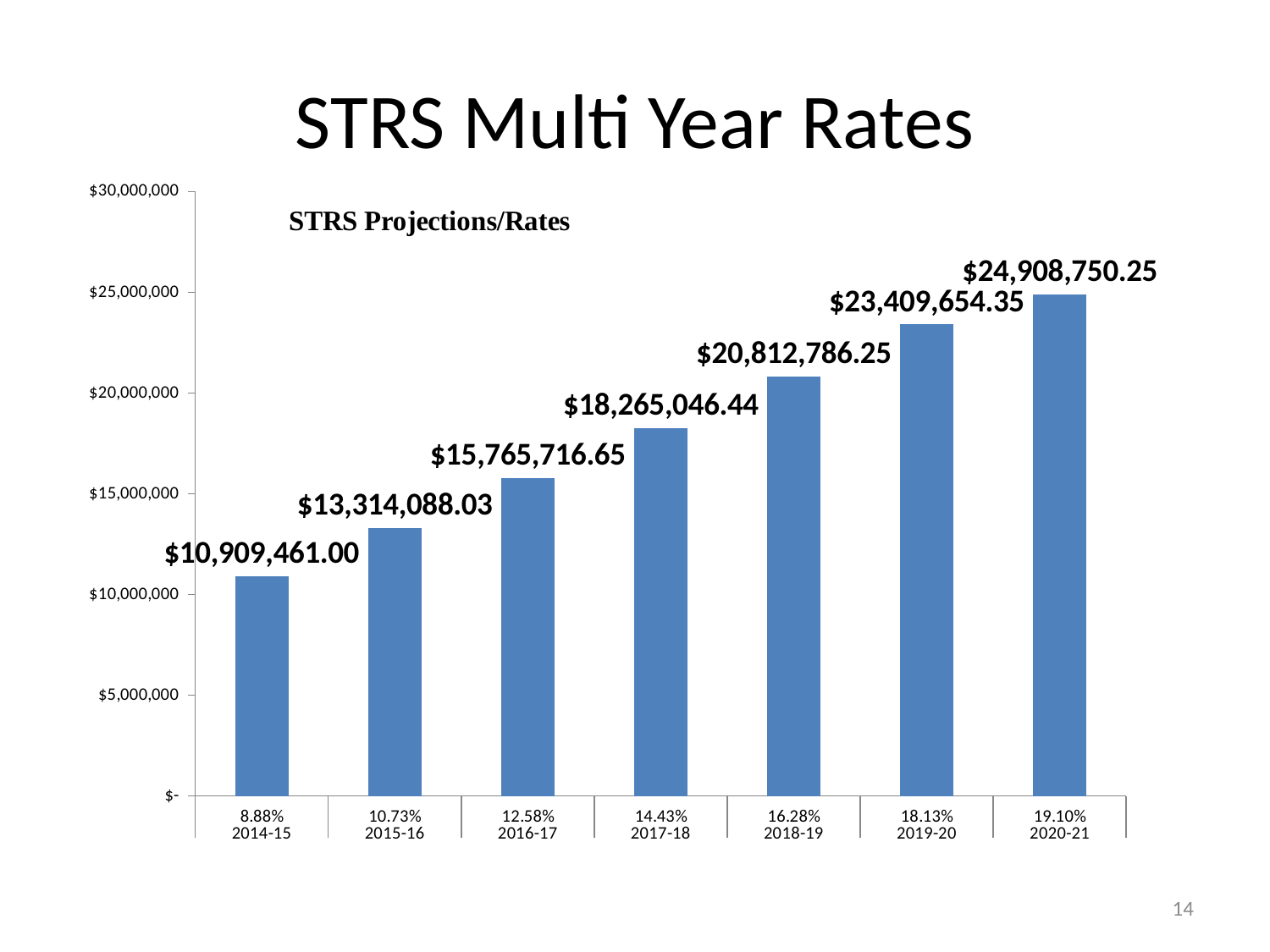
Which year has the highest value? 2020-21 What is the difference between the values for 2015-16 and 2014-15? $2,404,627.03 How many bars are shown in the chart? 7 What is the difference between the values for 2020-21 and 2014-15? $13,999,289.25 Is the value for 2019-20 greater or less than $20,000,000? greater Which is larger, the value for 2018-19 or the value for 2016-17? 2018-19 What kind of chart is shown on the slide? bar chart What is the value for 2020-21? $24,908,750.25 Do the values rise or fall from 2014-15 to 2020-21? rise What is the value for 2017-18? $18,265,046.44 What is the value for 2014-15? $10,909,461.00 Which year has the lowest value? 2014-15